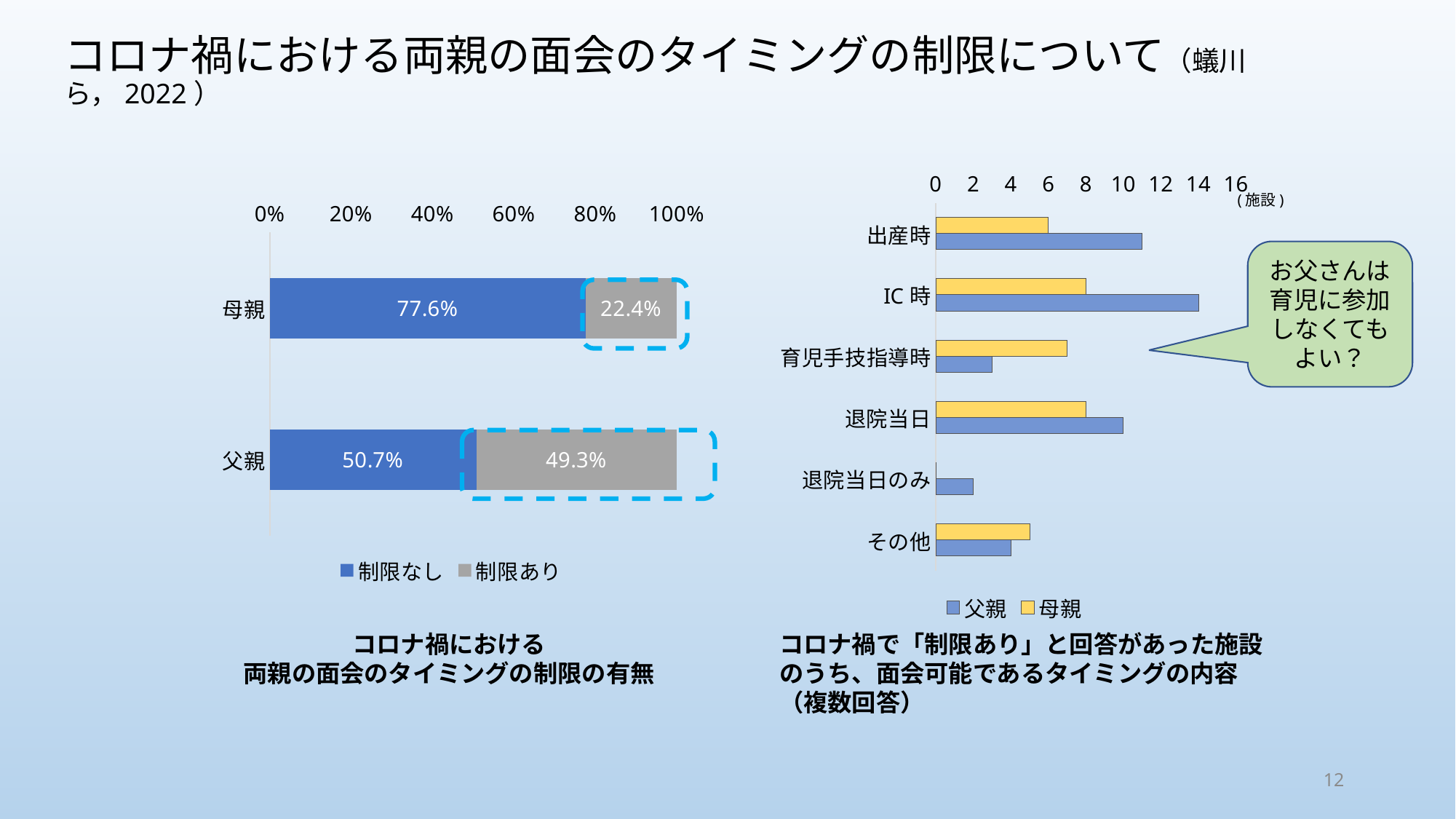
What kind of chart is the left chart? Stacked bar chart In the right chart, which category has the highest value for 父親? IC 時 In the left chart, what is the difference between the 制限なし values for 母親 and 父親? 26.9% In the left chart (コロナ禍における両親の面会のタイミングの制限の有無), what is the 制限なし value for 母親? 77.6% In the left chart, which has the larger 制限あり share, 母親 or 父親? 父親 In the right chart, for 育児手技指導時, which is larger, the 父親 value or the 母親 value? 母親 In the right chart, which category has the lowest value for 父親? 退院当日のみ In the left chart, how many series does the legend list? 2 In the left chart, what is the total of the stacked bar for 母親? 100% In the left chart, what is the 制限あり value for 父親? 49.3% In the right chart (面会可能であるタイミングの内容), how many categories are shown on the vertical axis? 6 In the right chart, is the 父親 value for IC 時 greater or less than 12? greater